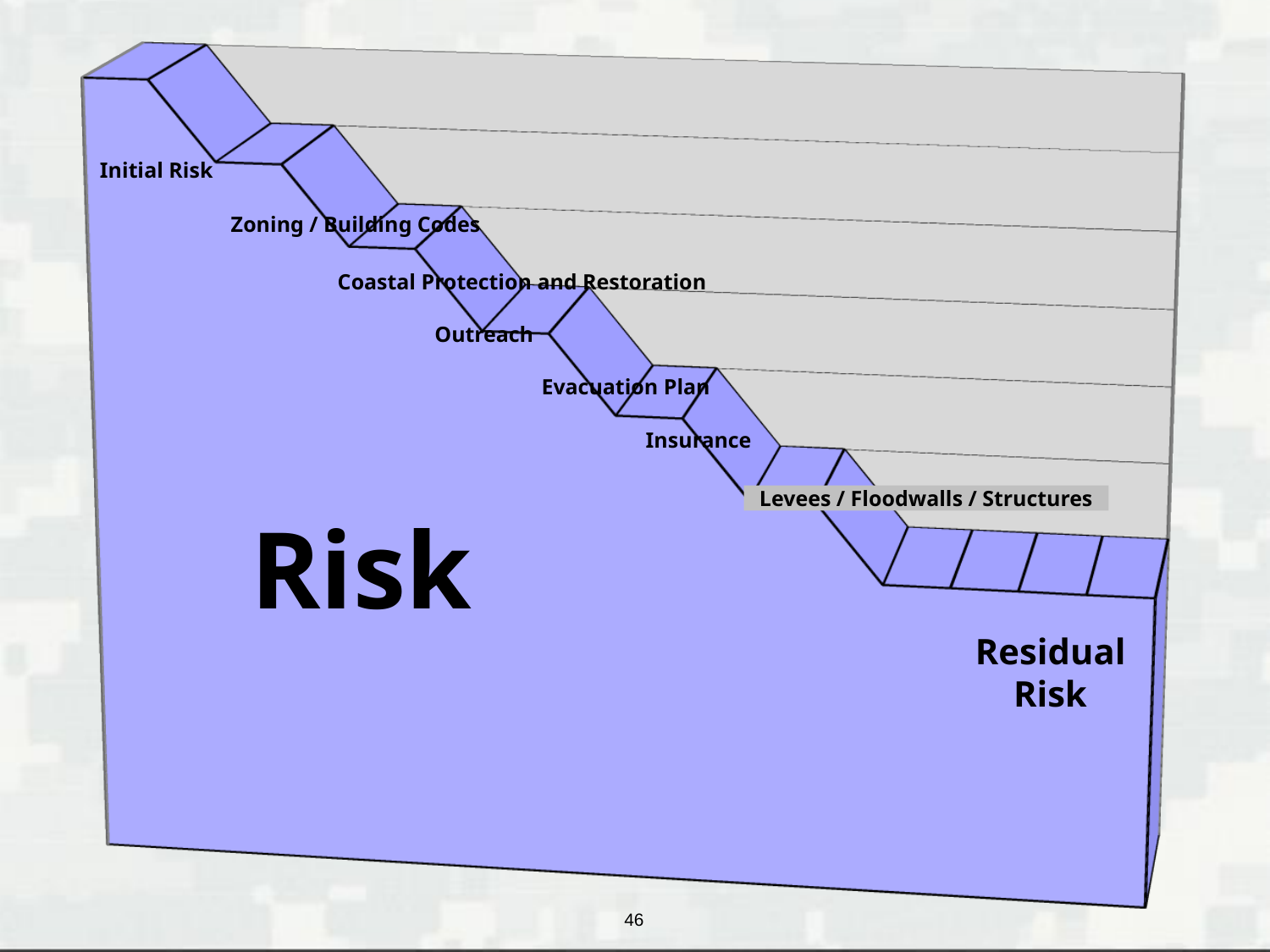
What label is shown at the bottom-right ending level of the staircase? Residual Risk What label is shown at the top-left starting level of the staircase? Initial Risk Does the level of risk shown in the staircase diagram rise or fall from left to right? fall How many risk-reduction measures are labelled as steps between Initial Risk and Residual Risk? 6 Which is larger in the diagram, Initial Risk or Residual Risk? Initial Risk